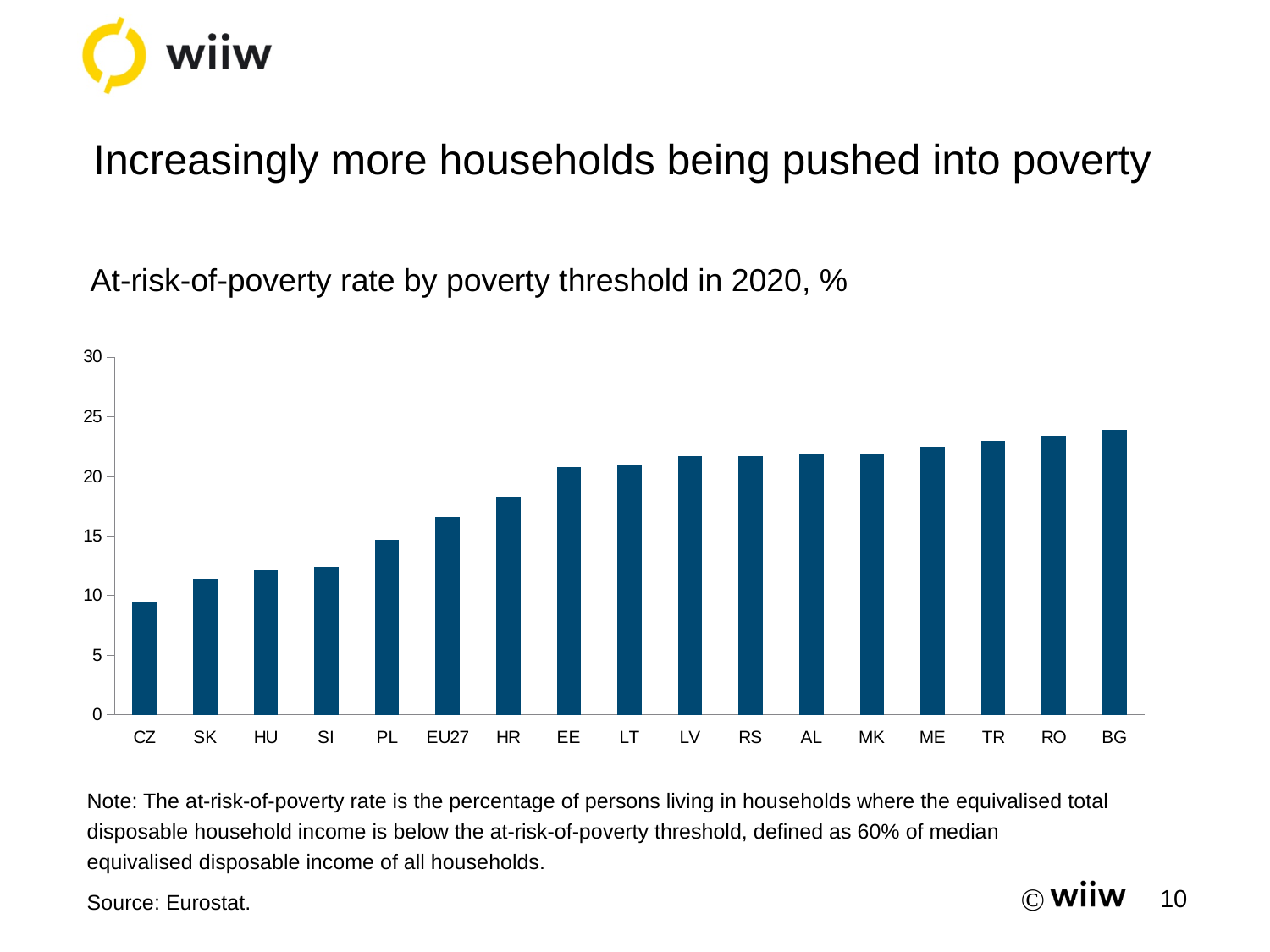
What kind of chart is shown on the slide? bar chart Is the value for EU27 greater or less than 15? greater Is the value for HR greater or less than 20? less Do the values generally rise or fall from left to right along the x axis? rise Which category has the lowest at-risk-of-poverty rate? CZ Is the value for BG greater or less than 25? less Which has a higher at-risk-of-poverty rate, SK or HR? HR Which category has the highest at-risk-of-poverty rate? BG How many categories are shown on the x axis of the chart? 17 What is the title of the chart? At-risk-of-poverty rate by poverty threshold in 2020, %